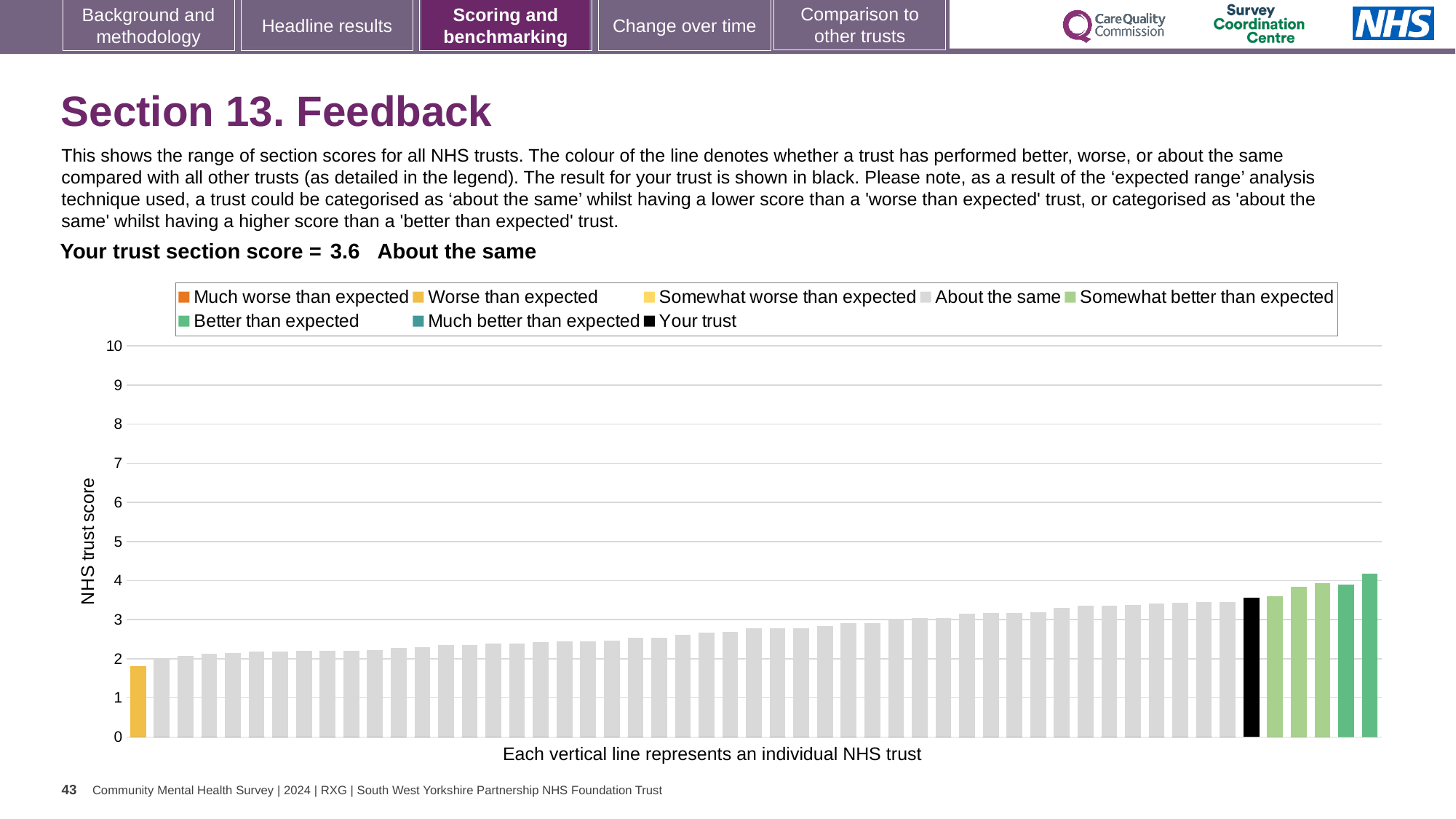
Is the value of the black bar (your trust) greater or less than 3? greater Do the bar values rise or fall from left to right along the x axis? rise Which category is your trust placed in for this section? About the same Is the value of the leftmost bar greater or less than 2? less What is the section score for your trust? 3.6 Is the value of the black bar (your trust) greater or less than 4? less According to the legend, what does the black bar represent? Your trust What kind of chart is shown on the slide? bar chart Which is larger, the leftmost bar or the rightmost bar? the rightmost bar How many entries does the chart legend list? 8 What is the highest value shown on the y axis? 10